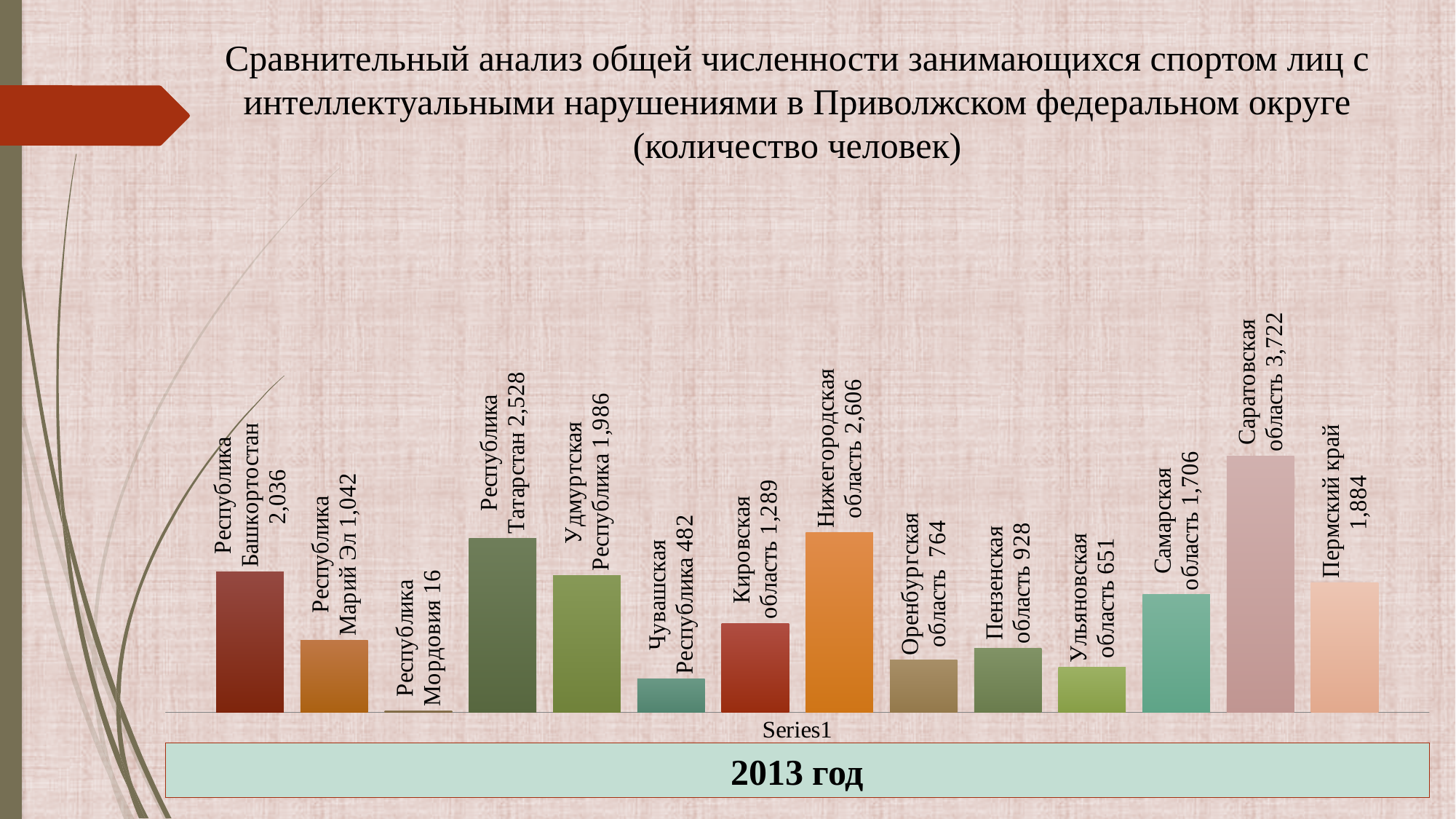
What is the difference between the values for Саратовская область and Республика Башкортостан? 1,686 What is the value for Кировская область? 1,289 Which region has the lowest value in the chart? Республика Мордовия What is the value for Пермский край? 1,884 How many regions (bars) are shown in the chart? 14 Which region has the highest value in the chart? Саратовская область What is the difference between the values for Нижегородская область and Оренбургская область? 1,842 Which has a larger value, Пензенская область or Ульяновская область? Пензенская область Which has a larger value, Самарская область or Удмуртская Республика? Удмуртская Республика What type of chart is shown on the slide? bar chart What year is indicated below the chart? 2013 год What is the value for Республика Татарстан? 2,528